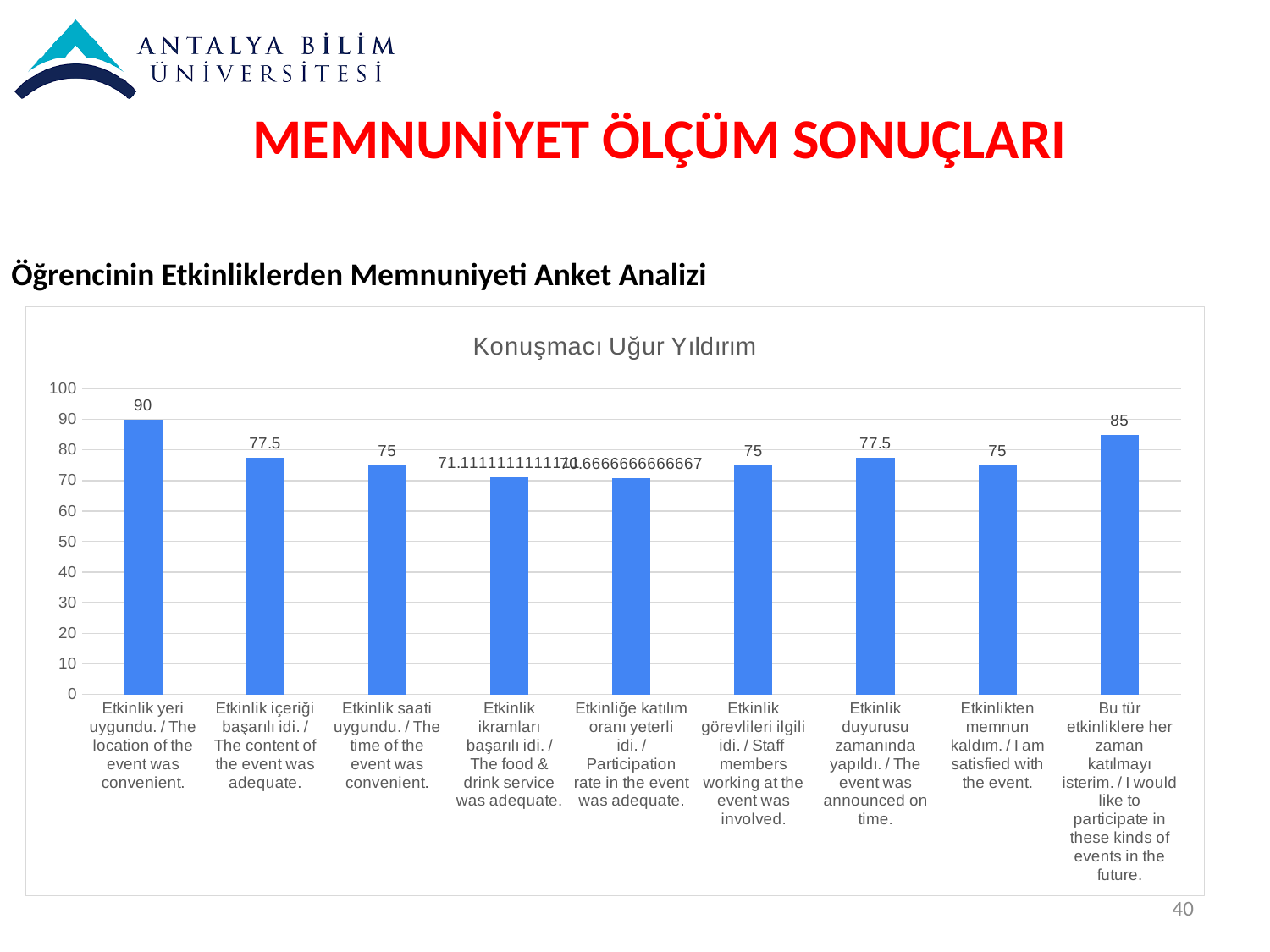
What is the title of the chart? Konuşmacı Uğur Yıldırım Is the value for "Etkinliğe katılım oranı yeterli idi. / Participation rate in the event was adequate." greater or less than 80? less What is the value for "Etkinlik yeri uygundu. / The location of the event was convenient."? 90 What is the value for "Etkinlik içeriği başarılı idi. / The content of the event was adequate."? 77.5 What is the difference between the value for "Etkinlik yeri uygundu. / The location of the event was convenient." and the value for "Bu tür etkinliklere her zaman katılmayı isterim. / I would like to participate in these kinds of events in the future."? 5 What is the value for "Etkinlik duyurusu zamanında yapıldı. / The event was announced on time."? 77.5 What type of chart is shown on the slide? bar chart What is the value for "Bu tür etkinliklere her zaman katılmayı isterim. / I would like to participate in these kinds of events in the future."? 85 Which is larger: the value for "Etkinlik içeriği başarılı idi. / The content of the event was adequate." or the value for "Etkinlik saati uygundu. / The time of the event was convenient."? Etkinlik içeriği başarılı idi. / The content of the event was adequate. How many categories (bars) are plotted in the chart? 9 Which category has the highest value? Etkinlik yeri uygundu. / The location of the event was convenient. What is the difference between the value for "Etkinlik duyurusu zamanında yapıldı. / The event was announced on time." and the value for "Etkinlikten memnun kaldım. / I am satisfied with the event."? 2.5